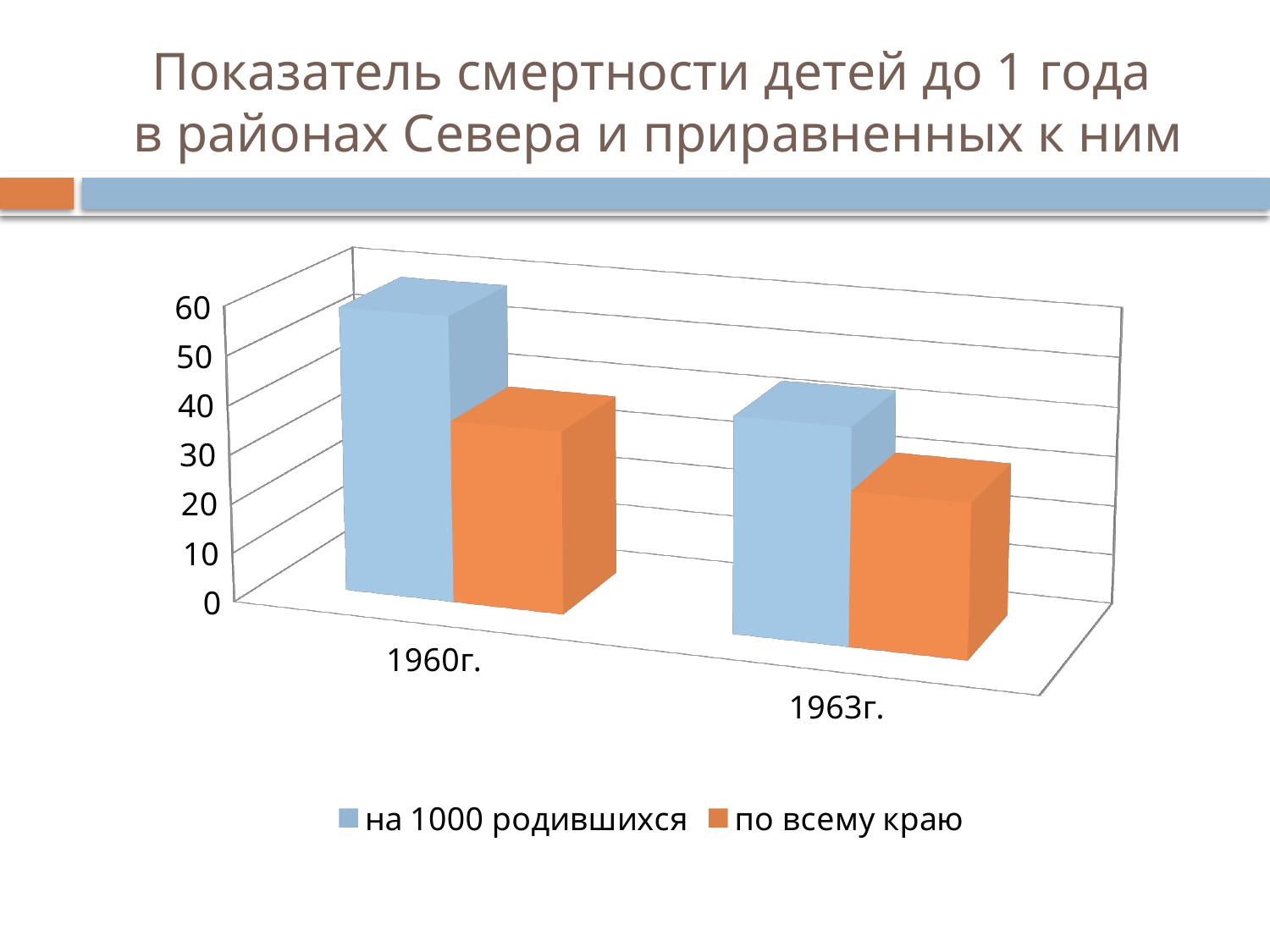
Which year has the lower value for the series 'по всему краю'? 1963г. Do the values for 'на 1000 родившихся' rise or fall from 1960г. to 1963г.? fall In 1960г., which series has the larger value: 'на 1000 родившихся' or 'по всему краю'? на 1000 родившихся What kind of chart is shown on the slide? bar chart Is the value for 'по всему краю' in 1963г. greater or less than 50? less How many categories (years) are shown on the x axis? 2 In 1963г., which series has the larger value: 'на 1000 родившихся' or 'по всему краю'? на 1000 родившихся How many series does the legend list? 2 Is the value for 'по всему краю' in 1960г. greater or less than 20? greater What colour represents the series 'по всему краю' in the legend? orange Is the value for 'на 1000 родившихся' in 1960г. greater or less than 50? greater Which year has the higher value for the series 'на 1000 родившихся'? 1960г.